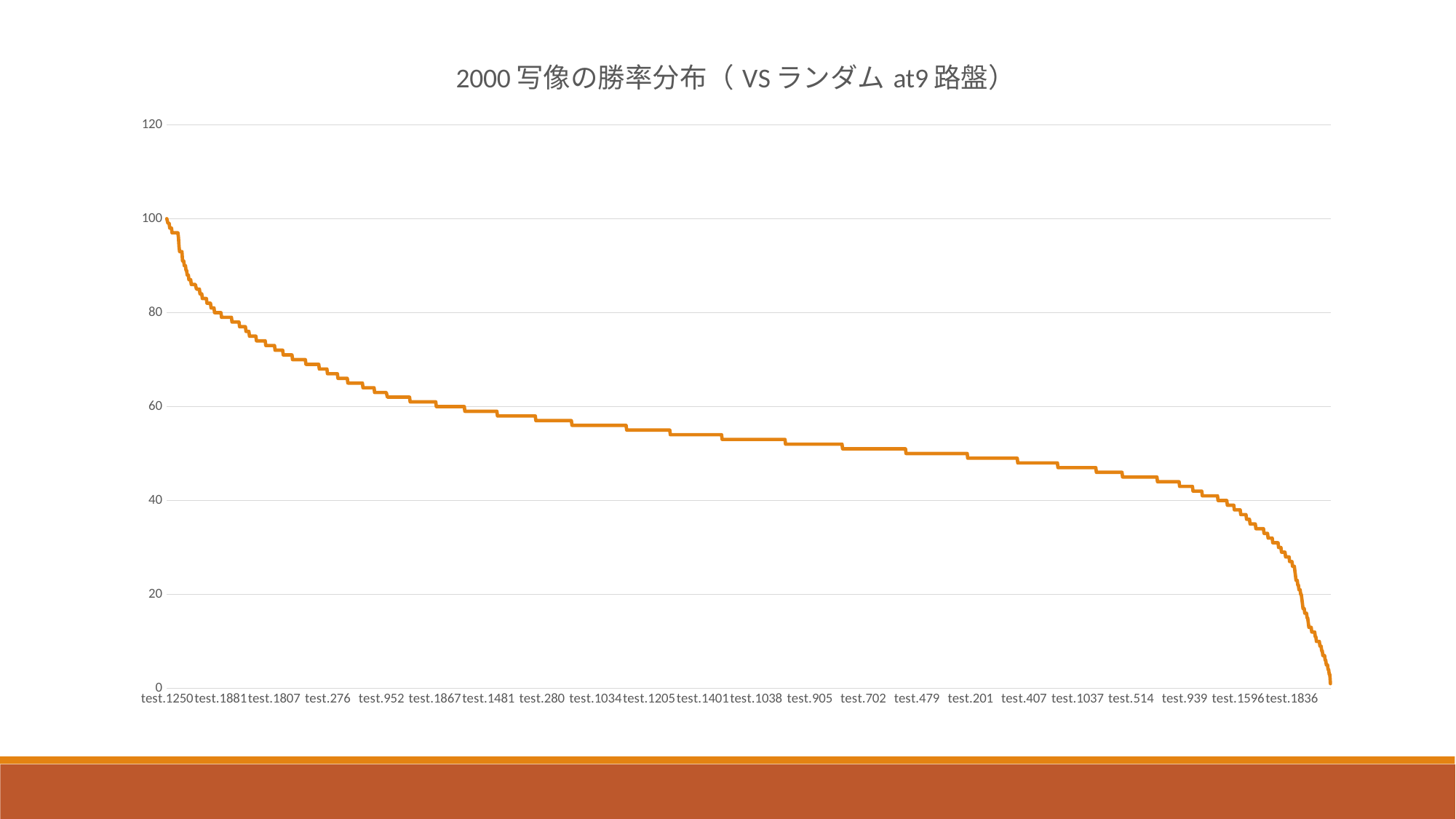
Which x-axis label has the lowest value? test.1836 Is the value for test.1596 greater or less than 20? greater What kind of chart is shown on the slide? line chart Is the value for test.276 greater or less than 60? greater Do the values rise or fall from left to right along the x axis? fall What is the title of the chart? 2000 写像の勝率分布（ VS ランダム at9 路盤） Is the value for test.1250 greater or less than 80? greater How many category labels are shown on the x axis? 22 Which is larger, the value for test.1807 or the value for test.939? test.1807 Which x-axis label has the highest value? test.1250